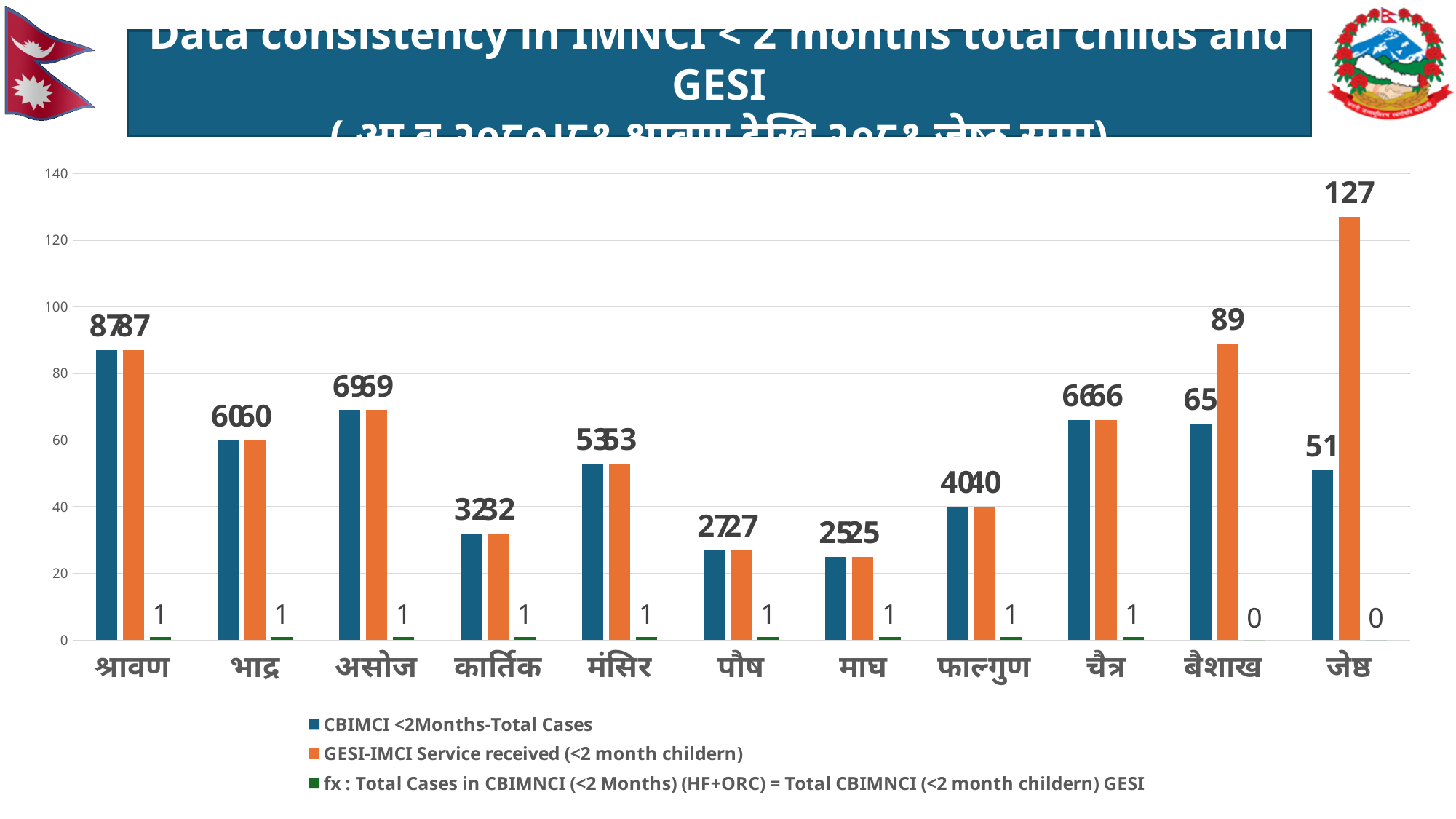
Which is larger for जेष्ठ: the CBIMCI <2Months-Total Cases value or the GESI-IMCI Service received value? GESI-IMCI Service received What colour are the bars for the GESI-IMCI Service received series? orange How many months (categories) are shown on the x axis? 11 Which month has the lowest CBIMCI <2Months-Total Cases value? माघ What is the fx series value for बैशाख? 0 How many series does the legend list? 3 What type of chart is shown on the slide? bar chart What is the CBIMCI <2Months-Total Cases value for बैशाख? 65 Which month has the highest GESI-IMCI Service received value? जेष्ठ What is the GESI-IMCI Service received value for जेष्ठ? 127 What is the difference between the GESI-IMCI Service received value and the CBIMCI <2Months-Total Cases value for बैशाख? 24 What is the CBIMCI <2Months-Total Cases value for श्रावण? 87